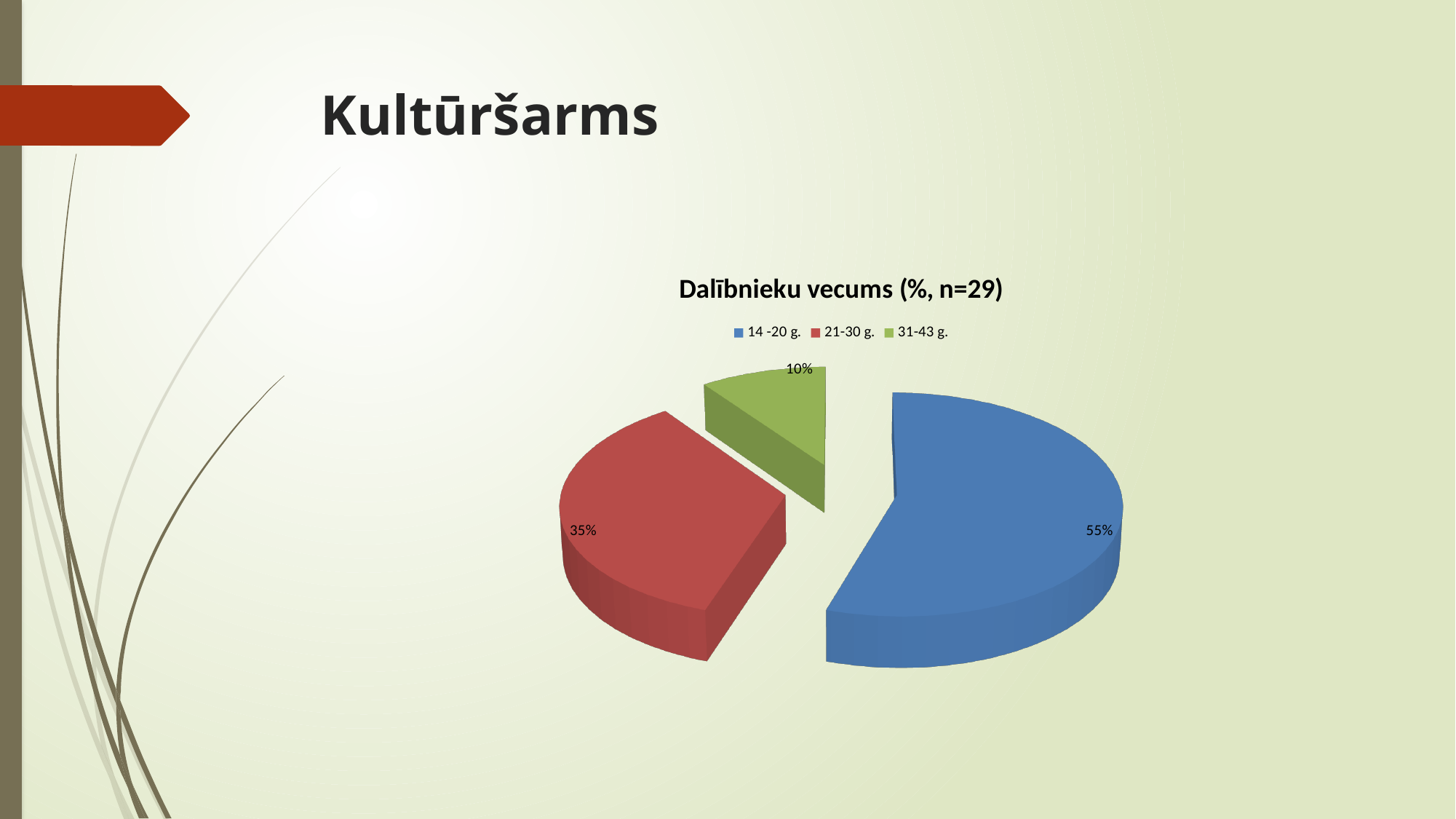
What is the title of the chart? Dalībnieku vecums (%, n=29) What percentage of participants are in the 21-30 g. age group? 35% Which age group has the smallest share of the pie? 31-43 g. How many age groups are shown in the pie chart? 3 What is the difference in percentage points between the 21-30 g. and 31-43 g. groups? 25 What is the difference in percentage points between the 14 -20 g. and 21-30 g. groups? 20 Which group has a larger share, 21-30 g. or 31-43 g.? 21-30 g. Which colour represents the 21-30 g. group in the legend? Red What percentage of participants are in the 14 -20 g. age group? 55% What kind of chart is shown on the slide? Pie chart What percentage of participants are in the 31-43 g. age group? 10% Which age group has the largest share of the pie? 14 -20 g.